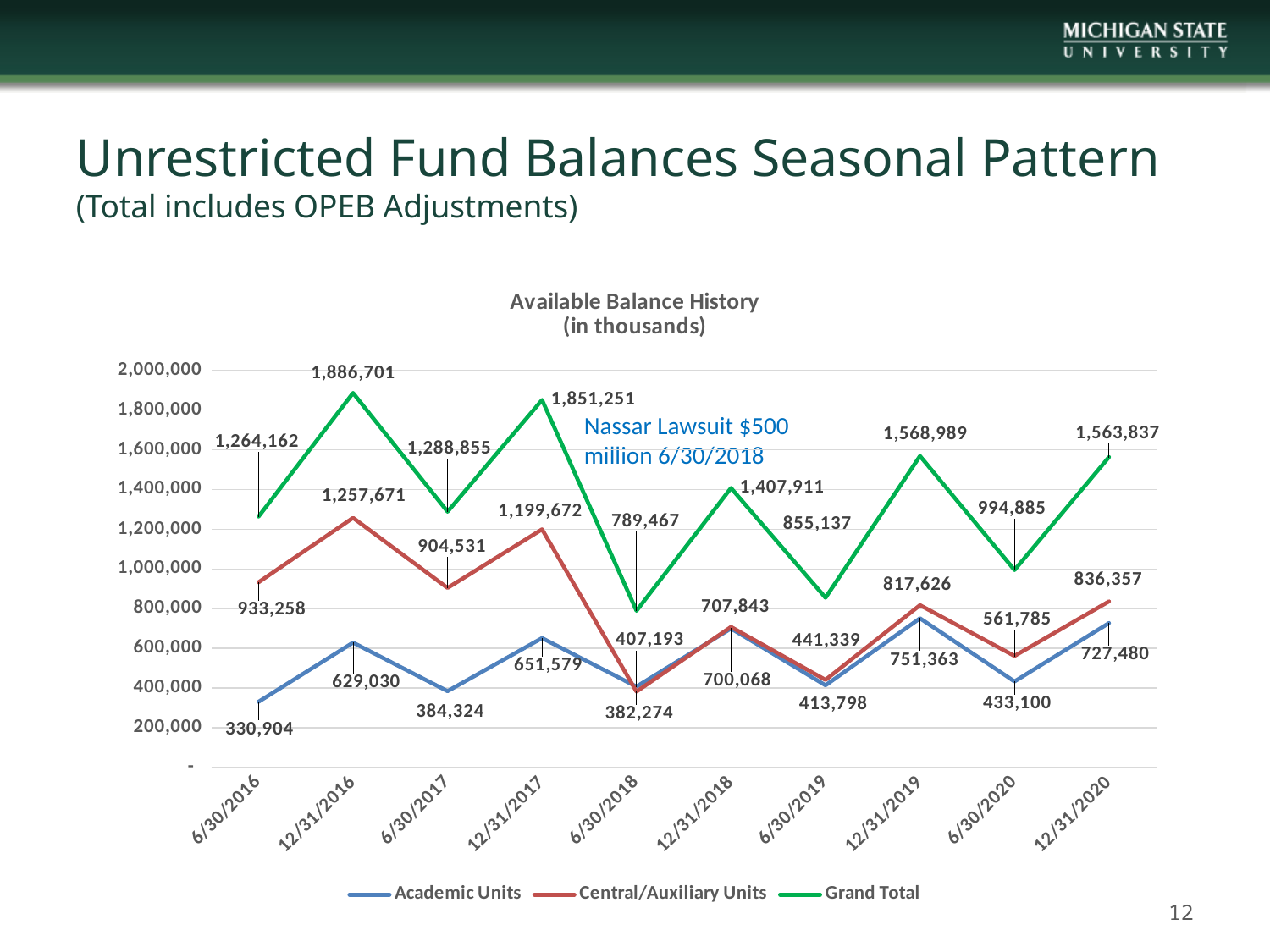
What is the difference between the Grand Total on 12/31/2017 and on 6/30/2018? 1,061,784 How many dates are plotted on the x axis? 10 What kind of chart is shown? Line chart Does the Grand Total rise or fall from 6/30/2018 to 12/31/2018? Rise What is the Grand Total value on 12/31/2016? 1,886,701 What is the Central/Auxiliary Units value on 12/31/2020? 836,357 On 12/31/2018, which is larger: Academic Units or Central/Auxiliary Units? Central/Auxiliary Units How many series does the legend list? 3 On which date is the Grand Total lowest? 6/30/2018 On which date is the Grand Total highest? 12/31/2016 What is the Academic Units value on 6/30/2018? 407,193 What is the difference between the Academic Units value on 12/31/2019 and on 6/30/2020? 318,263